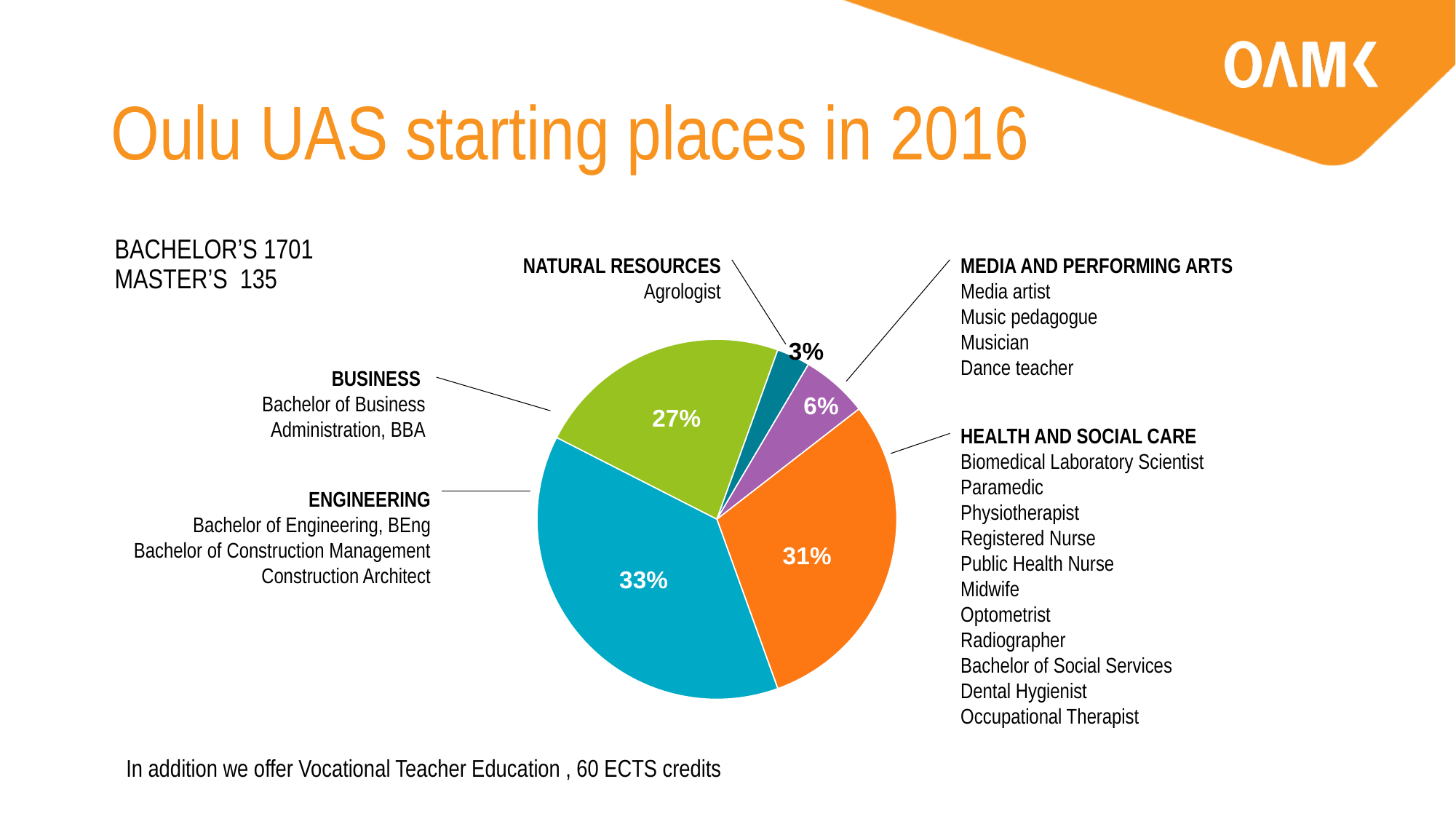
Which has a larger share, Health and Social Care or Business? Health and Social Care What is the title of the slide containing the pie chart? Oulu UAS starting places in 2016 What share of starting places does Engineering have? 33% Which field has the smallest share of starting places? Natural Resources What share of starting places does Media and Performing Arts have? 6% What share of starting places does Business have? 27% What share of starting places does Natural Resources have? 3% Which field has the largest share of starting places? Engineering What kind of chart is shown on the slide? pie chart What share of starting places does Health and Social Care have? 31% What is the difference in percentage points between Engineering and Business? 6 How many slices does the pie chart have? 5